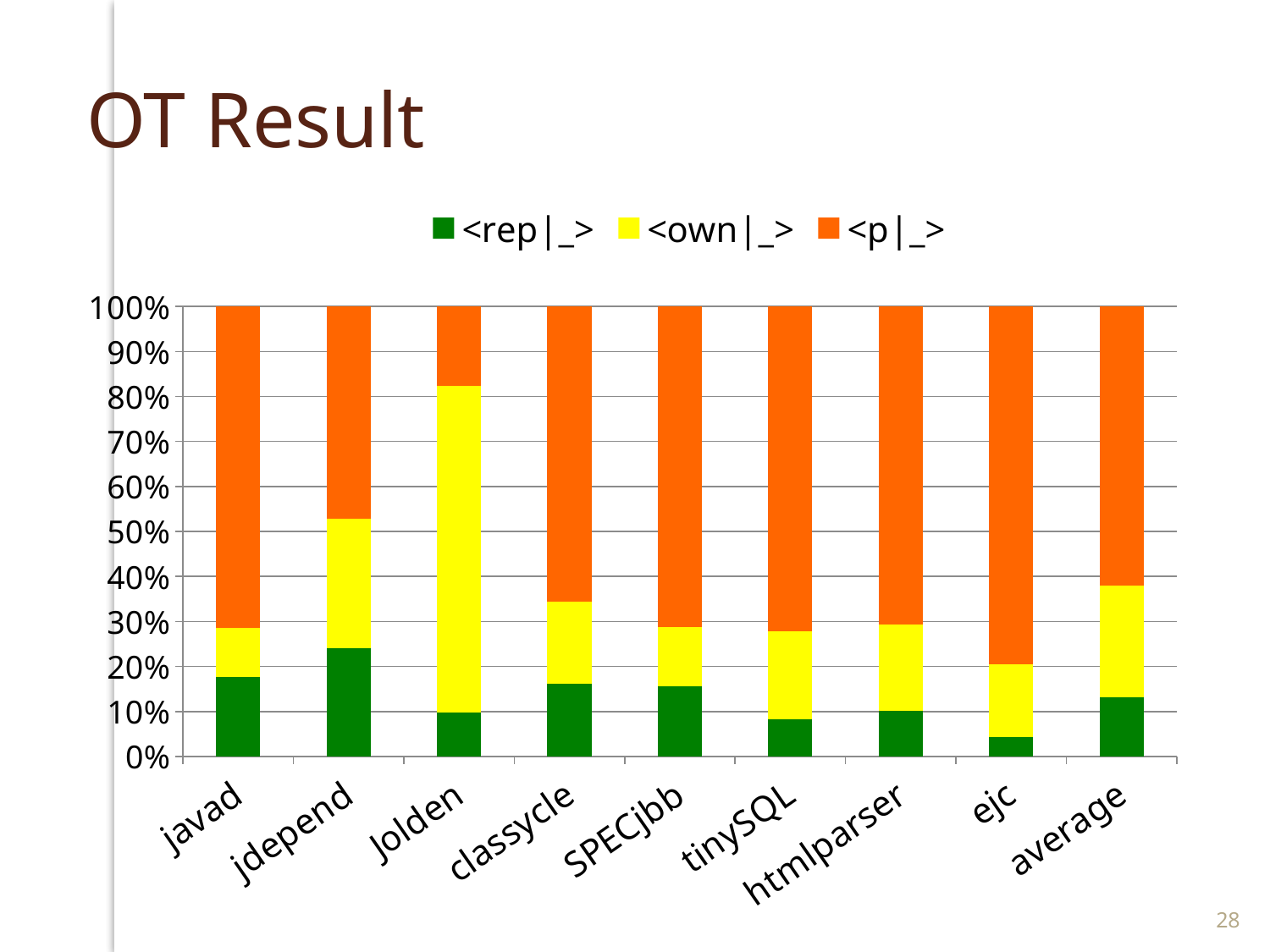
Which category has the smallest <rep|_> (green) segment? ejc Which colour represents the <own|_> series? yellow Is the <rep|_> value for ejc greater or less than 10%? less How many series does the legend list? 3 What is the total height of the stacked bar for javad? 100% Is the <rep|_> value for jdepend greater or less than 20%? greater Which category has the smallest <p|_> (orange) segment? Jolden What kind of chart is shown on the slide? stacked bar chart Which category has the largest <rep|_> (green) segment? jdepend Which category has the largest <own|_> (yellow) segment? Jolden How many categories are shown along the x axis? 9 What is the title of the slide containing the chart? OT Result